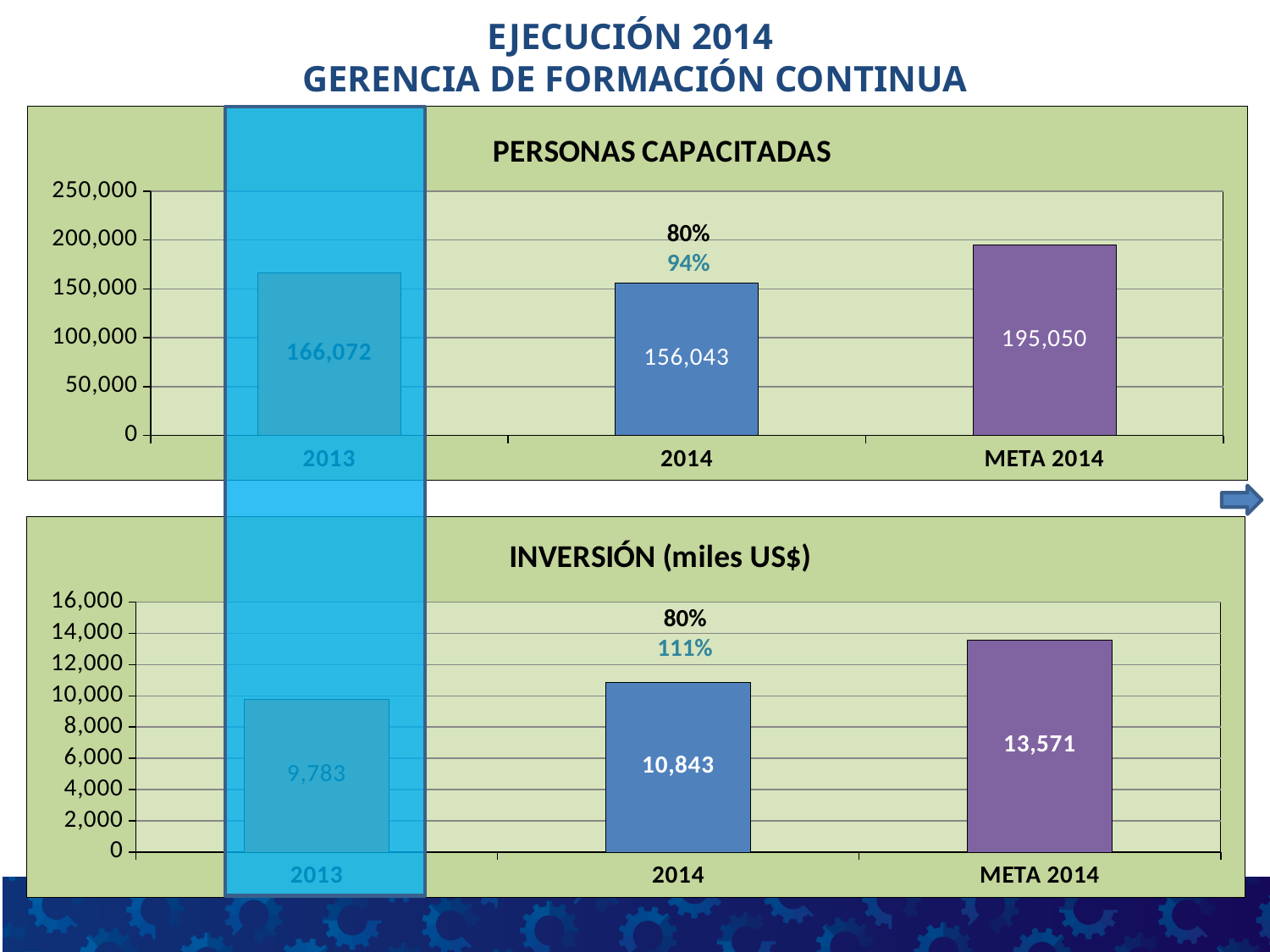
In the PERSONAS CAPACITADAS chart, what is the value for META 2014? 195,050 What type of chart is the PERSONAS CAPACITADAS chart? Bar chart In the INVERSIÓN (miles US$) chart, which is larger, 2013 or 2014? 2014 In the PERSONAS CAPACITADAS chart, what is the value for 2014? 156,043 How many categories are shown in the INVERSIÓN (miles US$) chart? 3 In the PERSONAS CAPACITADAS chart, which category has the highest value? META 2014 In the INVERSIÓN (miles US$) chart, what is the value for 2013? 9,783 In the PERSONAS CAPACITADAS chart, what is the difference between META 2014 and 2014? 39,007 In the INVERSIÓN (miles US$) chart, what is the value for 2014? 10,843 In the INVERSIÓN (miles US$) chart, what is the difference between META 2014 and 2014? 2,728 In the PERSONAS CAPACITADAS chart, what is the value for 2013? 166,072 In the PERSONAS CAPACITADAS chart, which category has the lowest value? 2014